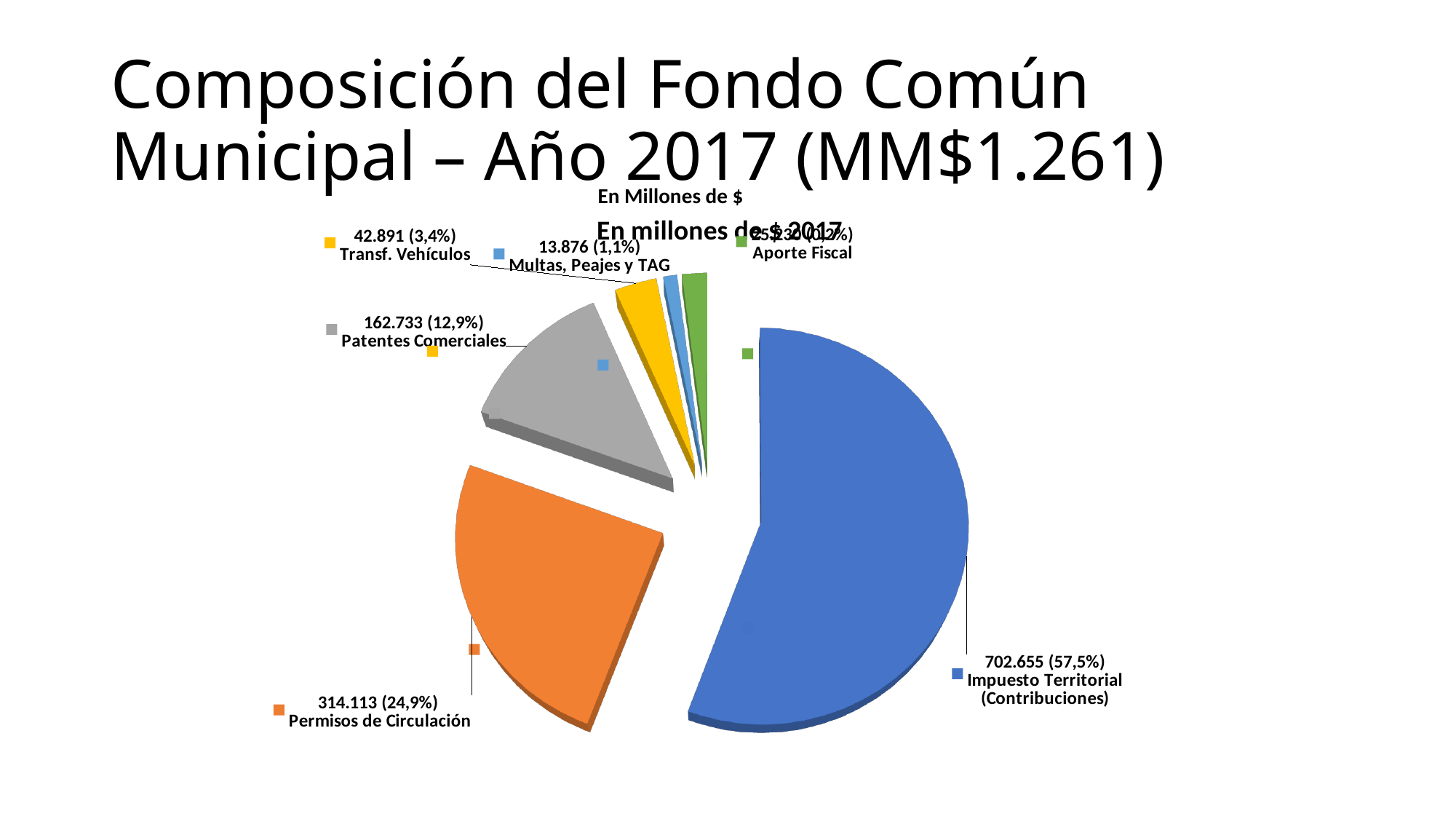
What is the difference between the values for Impuesto Territorial (Contribuciones) and Permisos de Circulación? 388.542 What is the value for Multas, Peajes y TAG? 13.876 Which is larger, the value for Patentes Comerciales or the value for Transf. Vehículos? Patentes Comerciales What is the value for Transf. Vehículos? 42.891 What is the value for Permisos de Circulación? 314.113 Which category has the smallest slice of the pie? Multas, Peajes y TAG What share of the pie does Permisos de Circulación represent? 24,9% What is the value for Patentes Comerciales? 162.733 What is the value for Impuesto Territorial (Contribuciones)? 702.655 How many categories are shown in the pie chart? 6 What kind of chart is shown on the slide? pie chart Which category has the largest slice of the pie? Impuesto Territorial (Contribuciones)